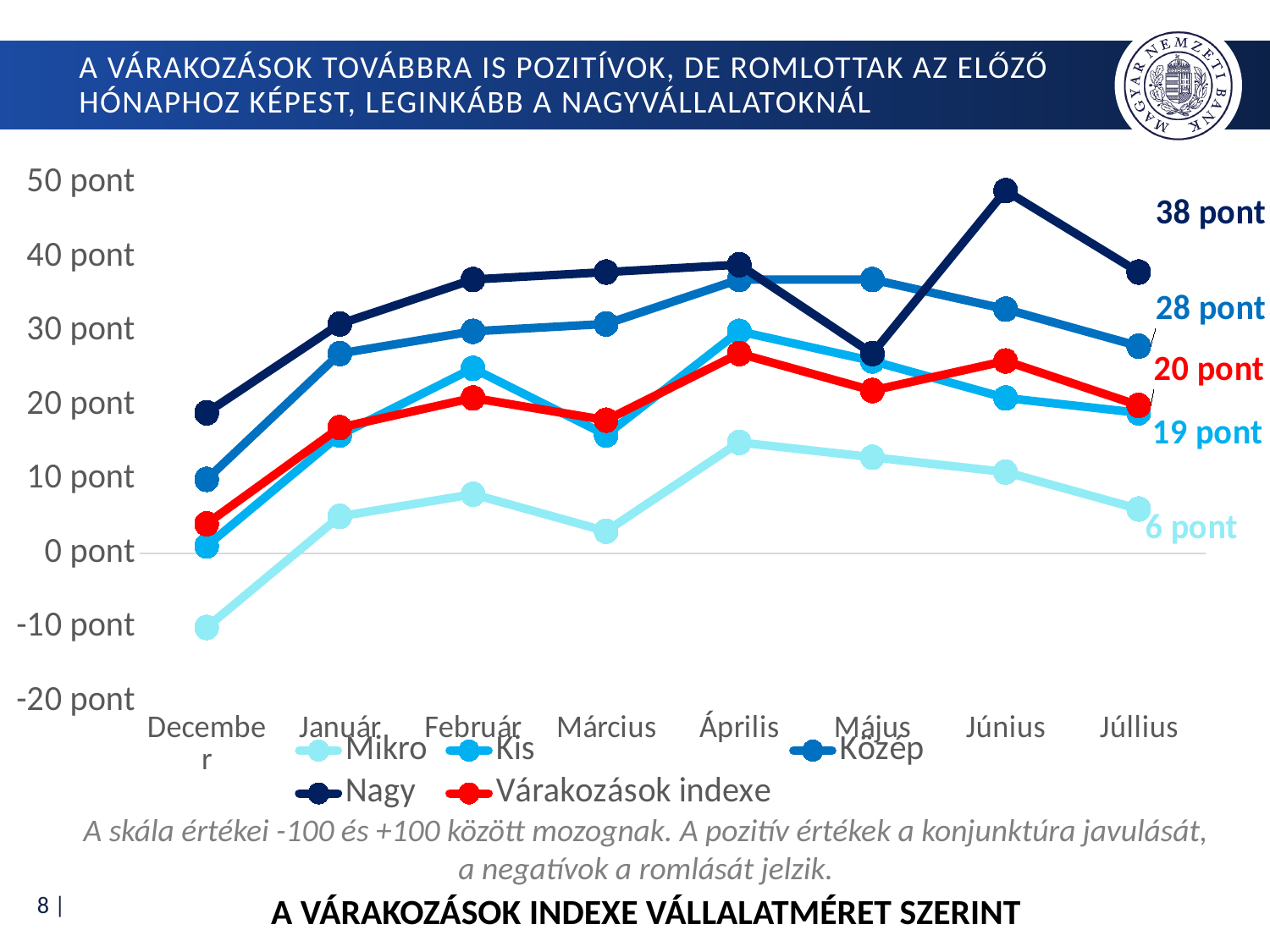
What is the difference between the Nagy and Közép values in Júllius? 10 pont In Május, which is larger: the Nagy value or the Közép value? Közép Is the value for Nagy in Június greater or less than 40 pont? greater How many months are shown on the x axis? 8 What is the value of the Várakozások indexe series in Júllius? 20 pont What is the value of the Mikro series in Júllius? 6 pont Which series has the lowest value in Júllius? Mikro What is the value of the Nagy series in Júllius? 38 pont What kind of chart is shown on the slide? line chart How many series does the legend list? 5 Which series has the highest value in Júllius? Nagy Is the value for Mikro in December greater or less than 0 pont? less